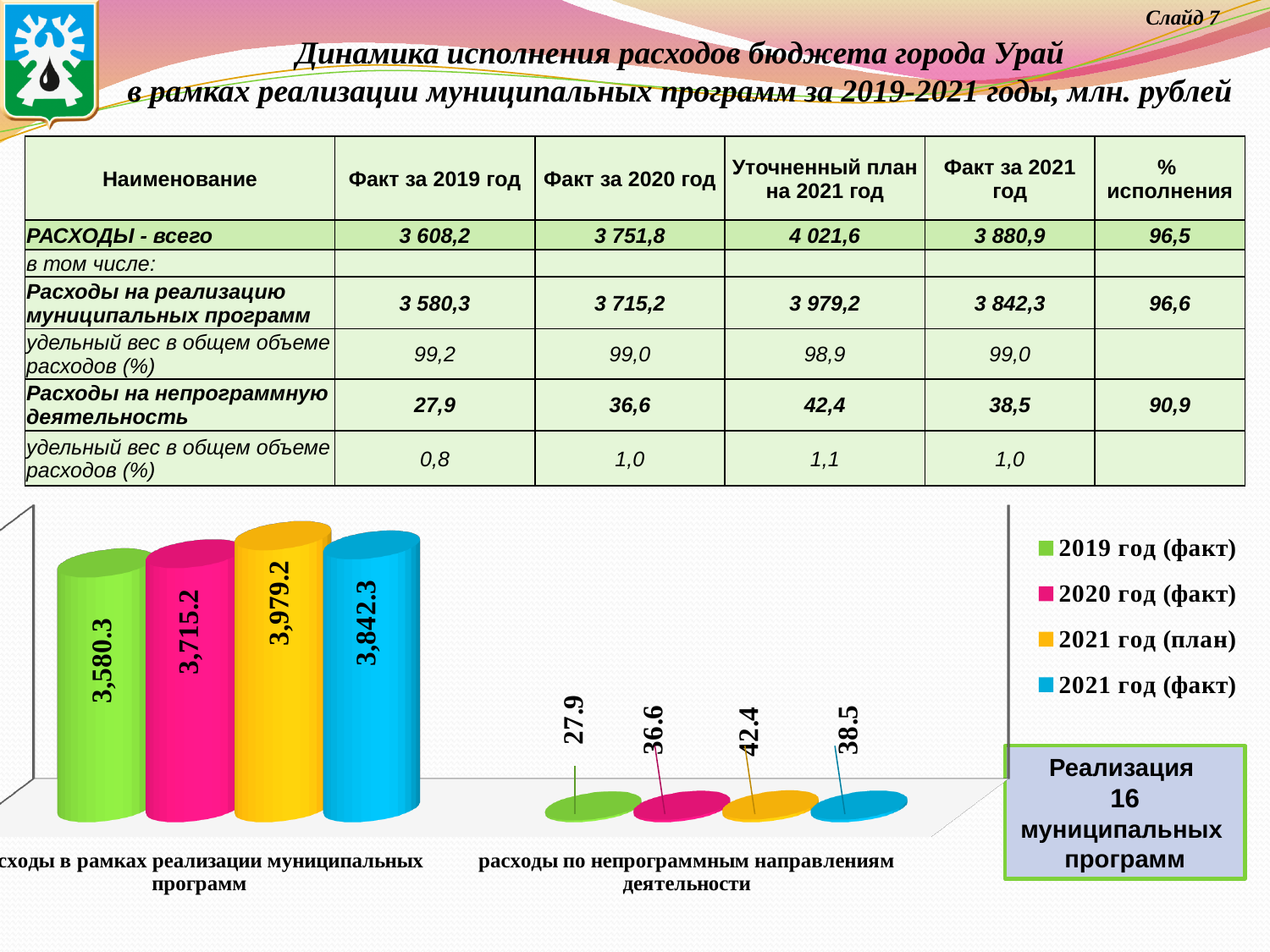
Which series has the lowest value in the group 'расходы по непрограммным направлениям деятельности'? 2019 год (факт) What is the value for 2021 год (факт) in the group 'расходы по непрограммным направлениям деятельности'? 38.5 What is the difference between the 2021 год (план) and 2021 год (факт) values in the group 'расходы в рамках реализации муниципальных программ'? 136.9 What is the value for 2020 год (факт) in the group 'расходы по непрограммным направлениям деятельности'? 36.6 Which is larger in the group 'расходы по непрограммным направлениям деятельности': the 2021 год (план) value or the 2021 год (факт) value? 2021 год (план) What is the value for 2021 год (план) in the group 'расходы в рамках реализации муниципальных программ'? 3,979.2 What kind of chart is shown at the bottom of the slide? bar chart Which series has the highest value in the group 'расходы в рамках реализации муниципальных программ'? 2021 год (план) What is the value for 2019 год (факт) in the group 'расходы в рамках реализации муниципальных программ'? 3,580.3 How many category groups are plotted on the chart? 2 How many series does the chart legend list? 4 Which colour represents 2021 год (факт) in the chart legend? blue